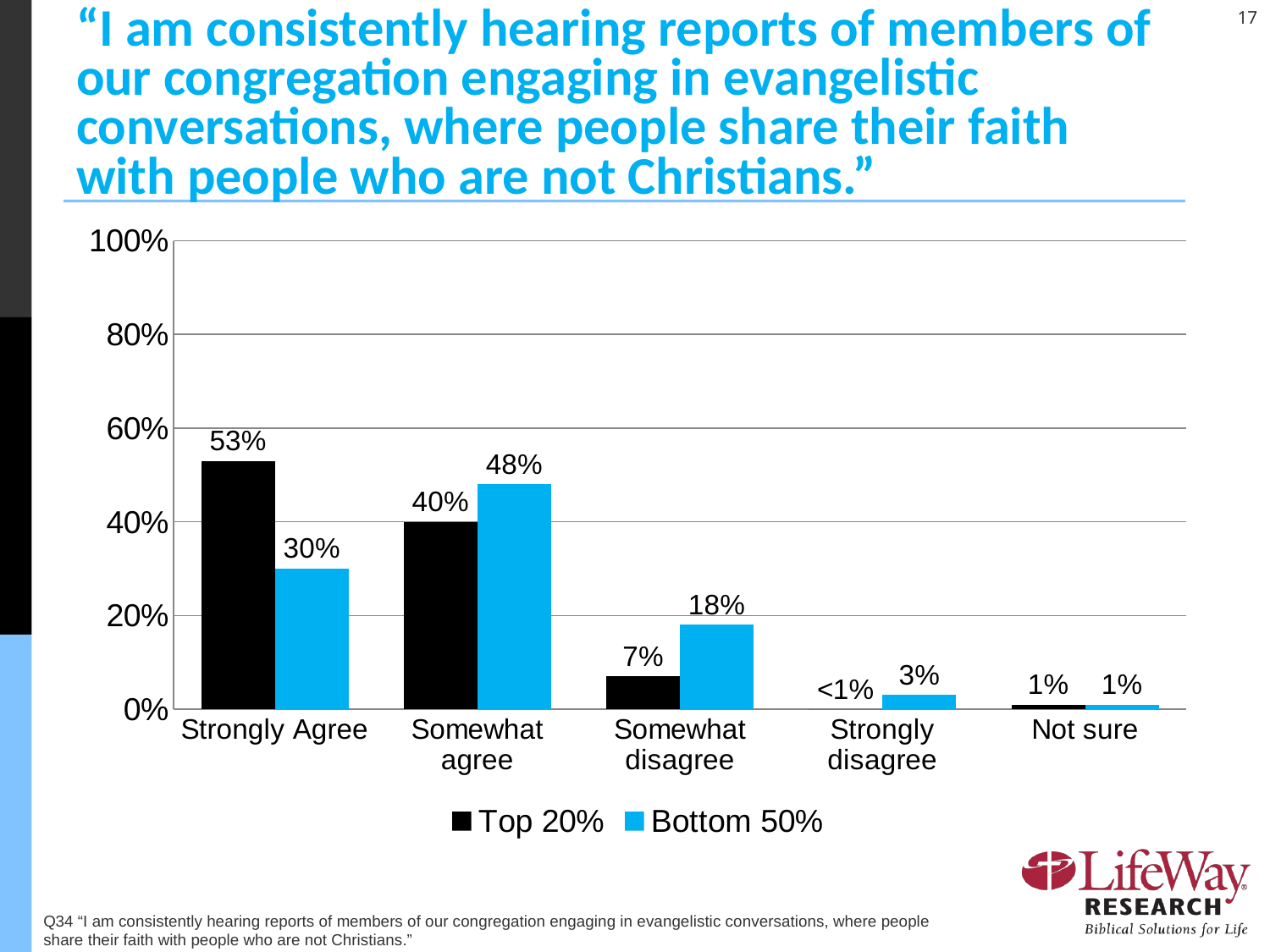
What kind of chart is shown on the slide? Bar chart Which colour represents the Bottom 50% series? Blue Which category has the highest value for the Bottom 50% series? Somewhat agree What is the value for Bottom 50% in the Somewhat agree category? 48% Which series has the larger value in the Somewhat disagree category, Top 20% or Bottom 50%? Bottom 50% How many categories are shown on the x axis? 5 What is the difference between Top 20% and Bottom 50% in the Strongly Agree category? 23% What is the value for Top 20% in the Strongly Agree category? 53% What is the value for Bottom 50% in the Somewhat disagree category? 18% What is the value for Top 20% in the Strongly disagree category? <1% Which category has the highest value for the Top 20% series? Strongly Agree How many series does the legend list? 2